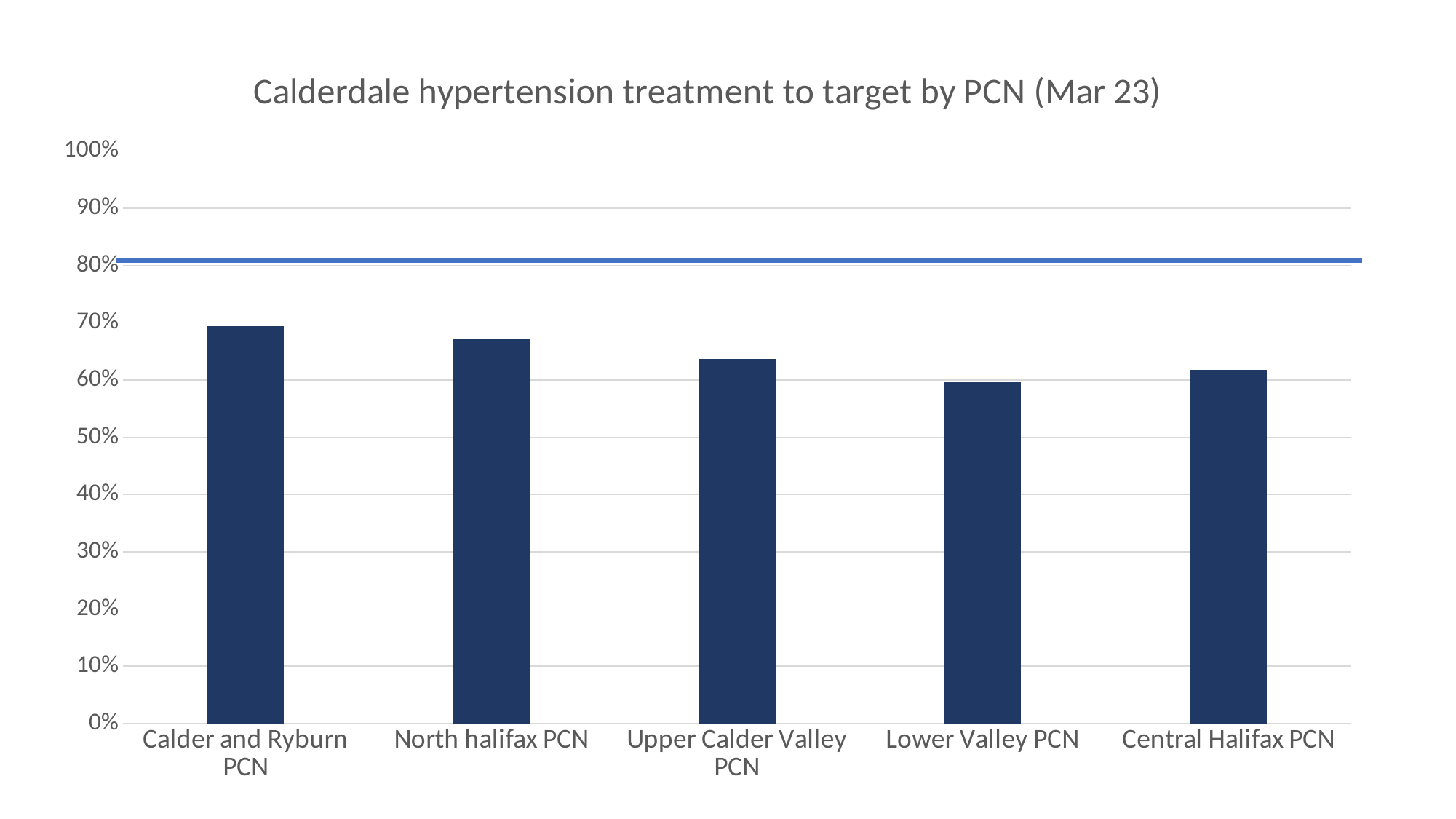
Is the value for North halifax PCN greater or less than 80%? less How many PCNs are shown on the x axis of the chart? 5 What kind of chart is shown on the slide? Bar chart Which is larger, the value for Calder and Ryburn PCN or the value for Upper Calder Valley PCN? Calder and Ryburn PCN What is the title of the chart? Calderdale hypertension treatment to target by PCN (Mar 23) Is the horizontal blue line on the chart above or below all of the bars? Above Which PCN has the highest hypertension treatment to target value? Calder and Ryburn PCN Is the value for Lower Valley PCN greater or less than 70%? less Is the value for Upper Calder Valley PCN greater or less than 60%? greater Which is larger, the value for North halifax PCN or the value for Lower Valley PCN? North halifax PCN Which PCN has the lowest hypertension treatment to target value? Lower Valley PCN